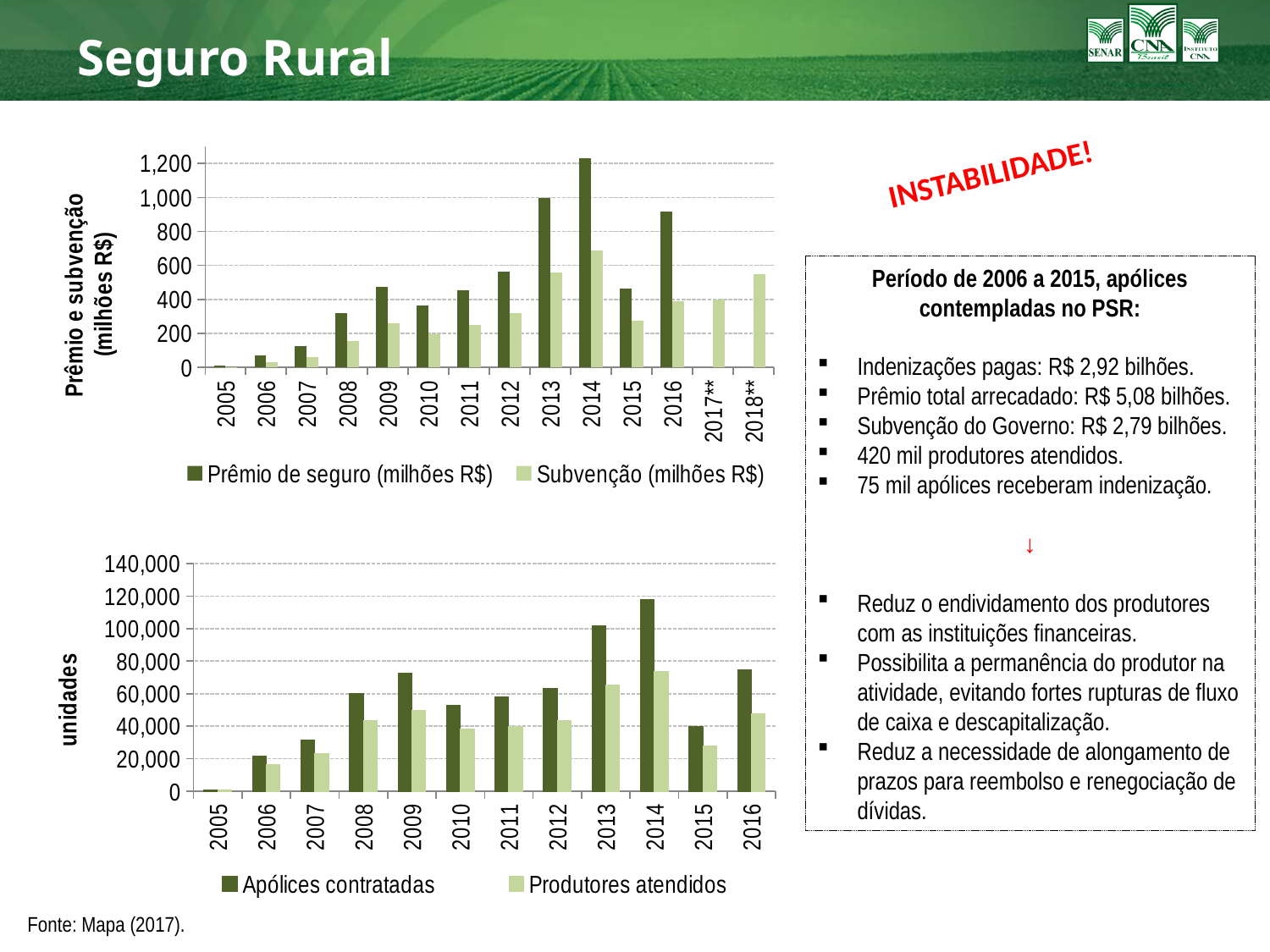
In the top chart (Prêmio e subvenção), which series is shown in the lighter green colour? Subvenção (milhões R$) In the top chart (Prêmio e subvenção), which is larger: the Prêmio de seguro for 2013 or for 2016? 2013 What kind of chart is the top chart on the slide (Prêmio e subvenção)? bar chart How many years are shown on the x axis of the bottom chart (unidades)? 12 In the bottom chart (unidades), which year has the highest number of Apólices contratadas? 2014 How many series does the legend of the top chart (Prêmio e subvenção) list? 2 In the top chart (Prêmio e subvenção), is the Subvenção for 2018** greater or less than 400? greater In the top chart (Prêmio e subvenção), which year has the highest Prêmio de seguro? 2014 In the top chart (Prêmio e subvenção), is the Prêmio de seguro for 2013 greater or less than 800? greater How many years are shown on the x axis of the top chart (Prêmio e subvenção)? 14 In the bottom chart (unidades), which year has the lowest number of Produtores atendidos? 2005 In the bottom chart (unidades), is the value of Produtores atendidos for 2015 greater or less than 40,000? less